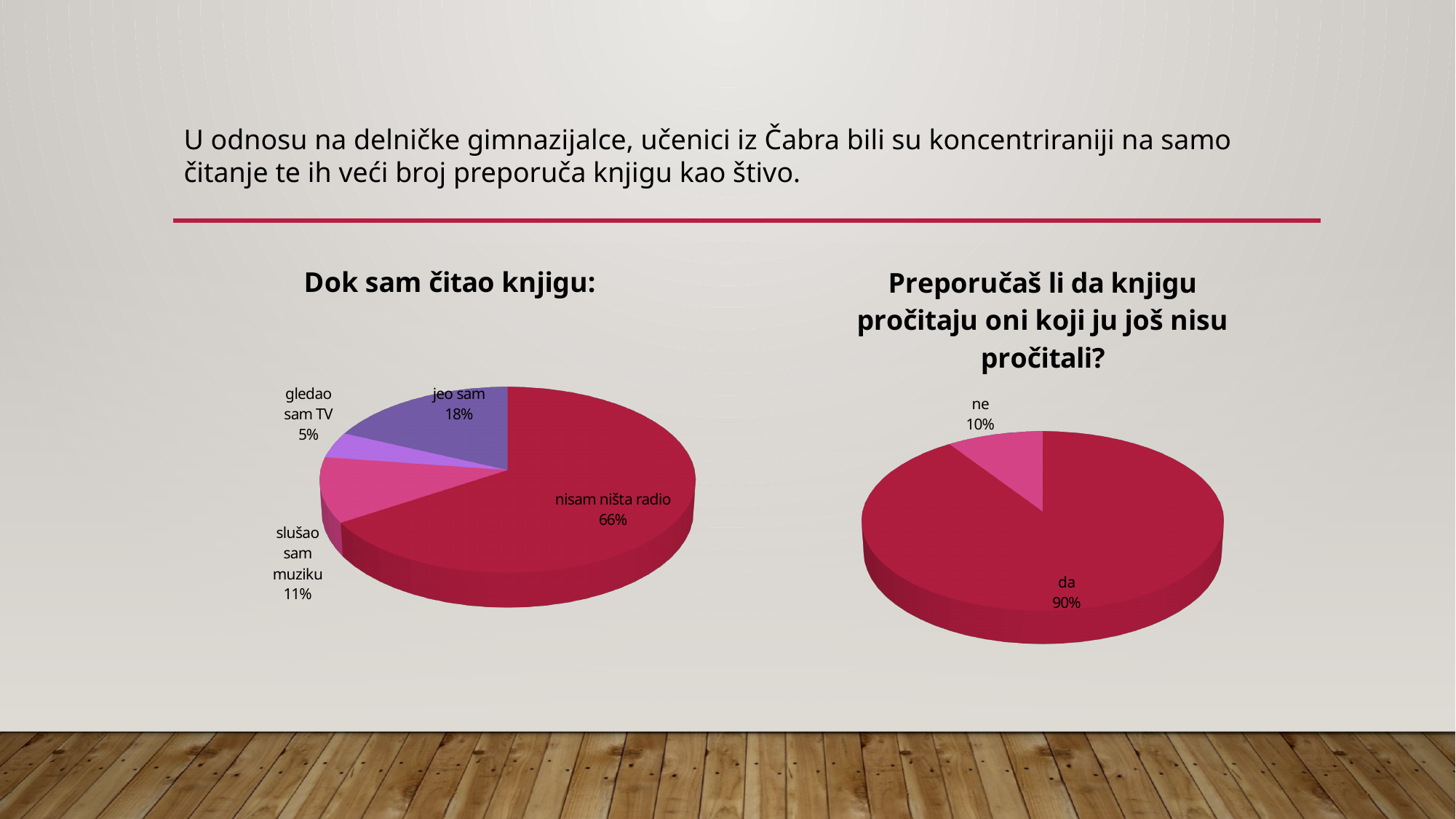
In the 'Dok sam čitao knjigu:' chart, what share is labelled for 'nisam ništa radio'? 66% In the 'Preporučaš li da knjigu pročitaju oni koji ju još nisu pročitali?' chart, what share is labelled for 'da'? 90% In the 'Dok sam čitao knjigu:' chart, which category has the smallest slice? gledao sam TV In the 'Dok sam čitao knjigu:' chart, which is larger, 'jeo sam' or 'slušao sam muziku'? jeo sam In the 'Dok sam čitao knjigu:' chart, what is the difference in percentage points between 'jeo sam' and 'gledao sam TV'? 13 In the 'Preporučaš li da knjigu pročitaju oni koji ju još nisu pročitali?' chart, what percentage is shown for 'ne'? 10% In the 'Dok sam čitao knjigu:' chart, what percentage is shown for 'jeo sam'? 18% How many pie charts are on the slide? 2 What type of chart is the 'Preporučaš li da knjigu pročitaju oni koji ju još nisu pročitali?' chart? pie chart In the 'Dok sam čitao knjigu:' chart, what percentage is shown for 'slušao sam muziku'? 11% In the 'Dok sam čitao knjigu:' chart, how many categories are shown? 4 In the 'Dok sam čitao knjigu:' chart, which category has the largest slice? nisam ništa radio